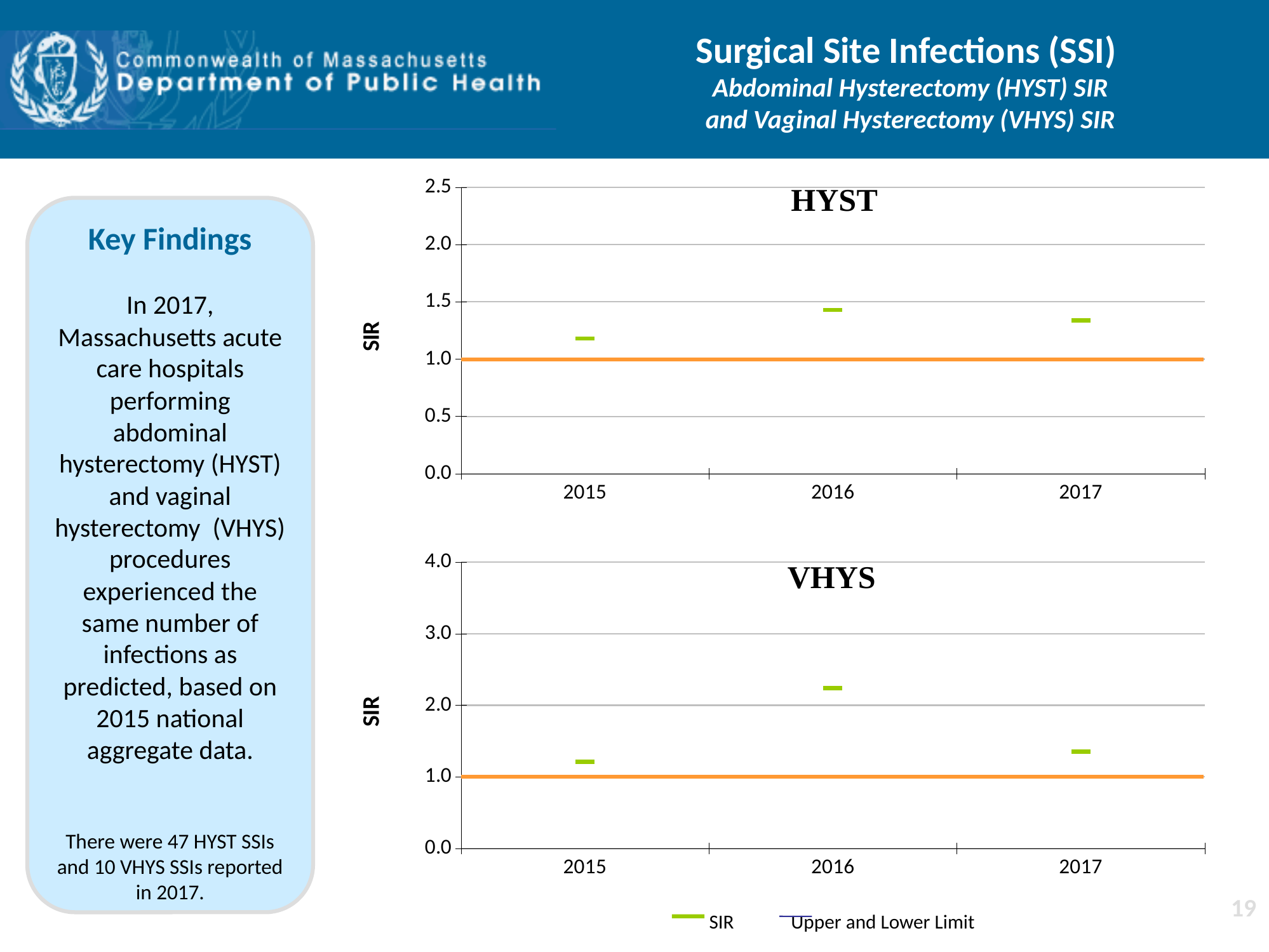
In the HYST chart, which year has the lowest SIR value? 2015 In the HYST chart, did the SIR value rise or fall from 2015 to 2016? rise In the HYST chart, is the SIR value for 2016 greater or less than 1.5? less In the HYST chart, is the SIR value for 2015 greater or less than 1.0? greater In the HYST chart, which year has the highest SIR value? 2016 In the HYST chart, which year has the larger SIR value, 2015 or 2016? 2016 In the VHYS chart, which year has the larger SIR value, 2016 or 2017? 2016 In the VHYS chart, is the SIR value for 2016 greater or less than 2.0? greater How many series does the legend at the bottom of the slide list? 2 How many years are plotted on the x axis of the VHYS chart? 3 In the VHYS chart, which year has the highest SIR value? 2016